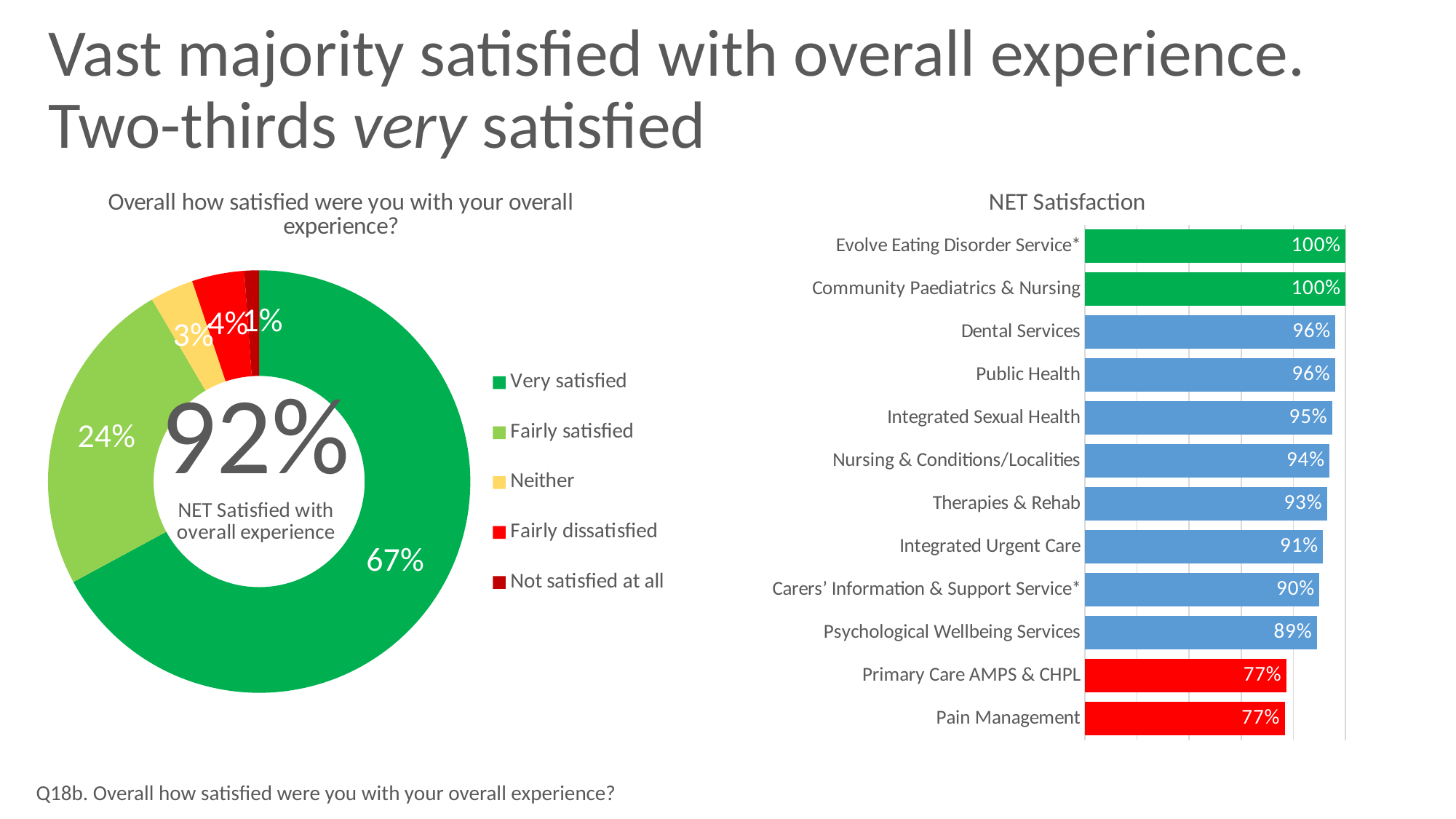
In the NET Satisfaction chart, what is the value for Dental Services? 96% In the NET Satisfaction chart, what is the value for Psychological Wellbeing Services? 89% In the NET Satisfaction chart, what is the difference between Integrated Sexual Health and Integrated Urgent Care? 4 percentage points How many categories does the legend of the donut chart on the left list? 5 How many services are listed in the NET Satisfaction chart? 12 What figure is shown in the centre of the donut chart on the left? 92% In the donut chart on the left, what share of respondents were Very satisfied? 67% In the NET Satisfaction chart, which service has the lowest value? Primary Care AMPS & CHPL and Pain Management (both 77%) In the donut chart on the left, which category has the smallest share? Not satisfied at all In the donut chart on the left, what share of respondents were Fairly dissatisfied? 4% In the NET Satisfaction chart, which is larger: Therapies & Rehab or Carers' Information & Support Service*? Therapies & Rehab What kind of chart is the NET Satisfaction chart? Bar chart